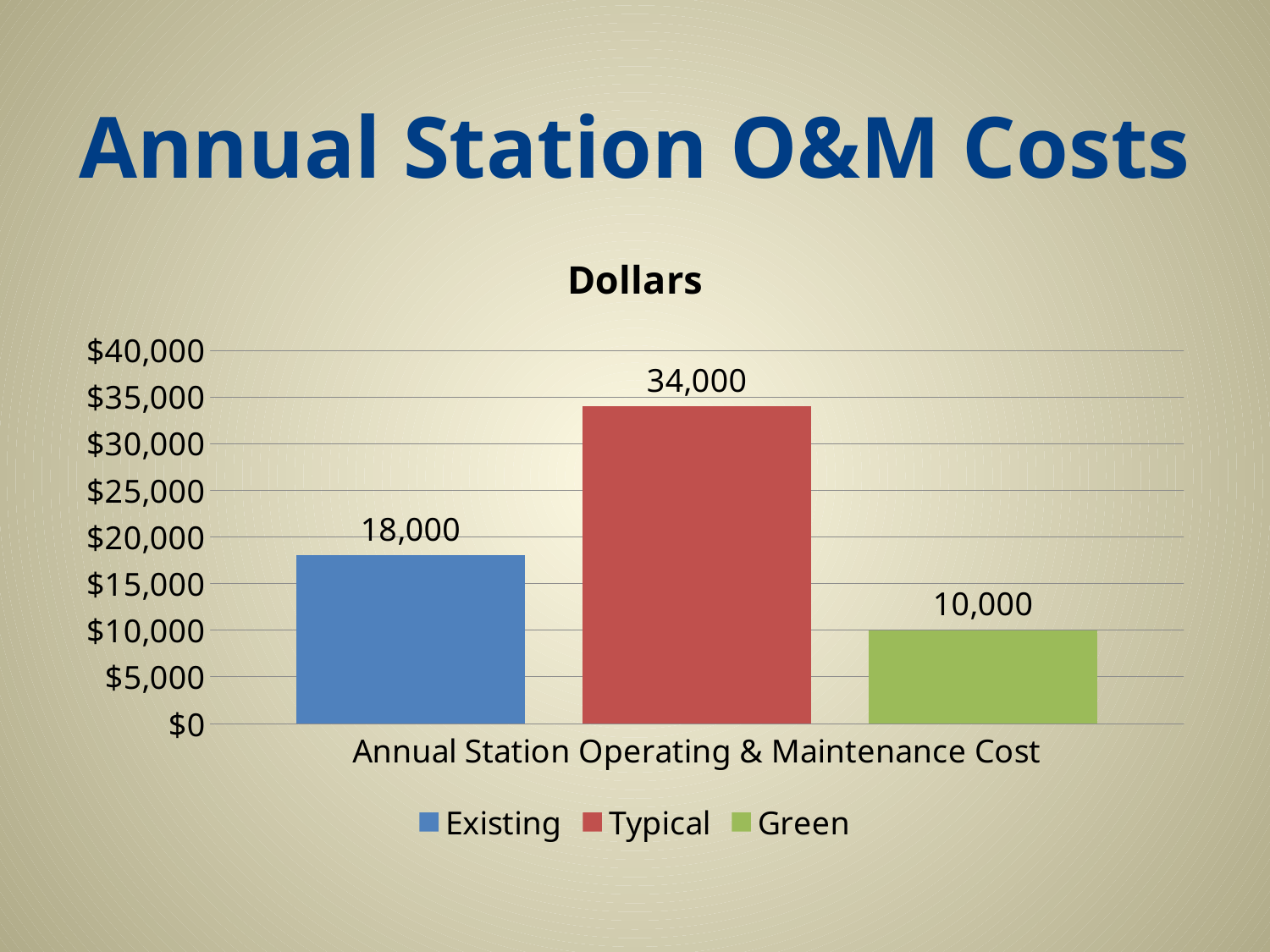
How many series does the legend list? 3 What is the value for the Typical series? 34,000 What is the value for the Existing series? 18,000 Which series has the lowest annual station operating & maintenance cost? Green What is the difference between the Existing and Green values? 8,000 Is the value for Typical greater or less than $30,000? greater Which series has the highest annual station operating & maintenance cost? Typical Which is larger, the value for Existing or the value for Green? Existing What is the difference between the Typical and Existing values? 16,000 What kind of chart is shown on the slide? bar chart What is the title of the chart? Dollars What is the value for the Green series? 10,000